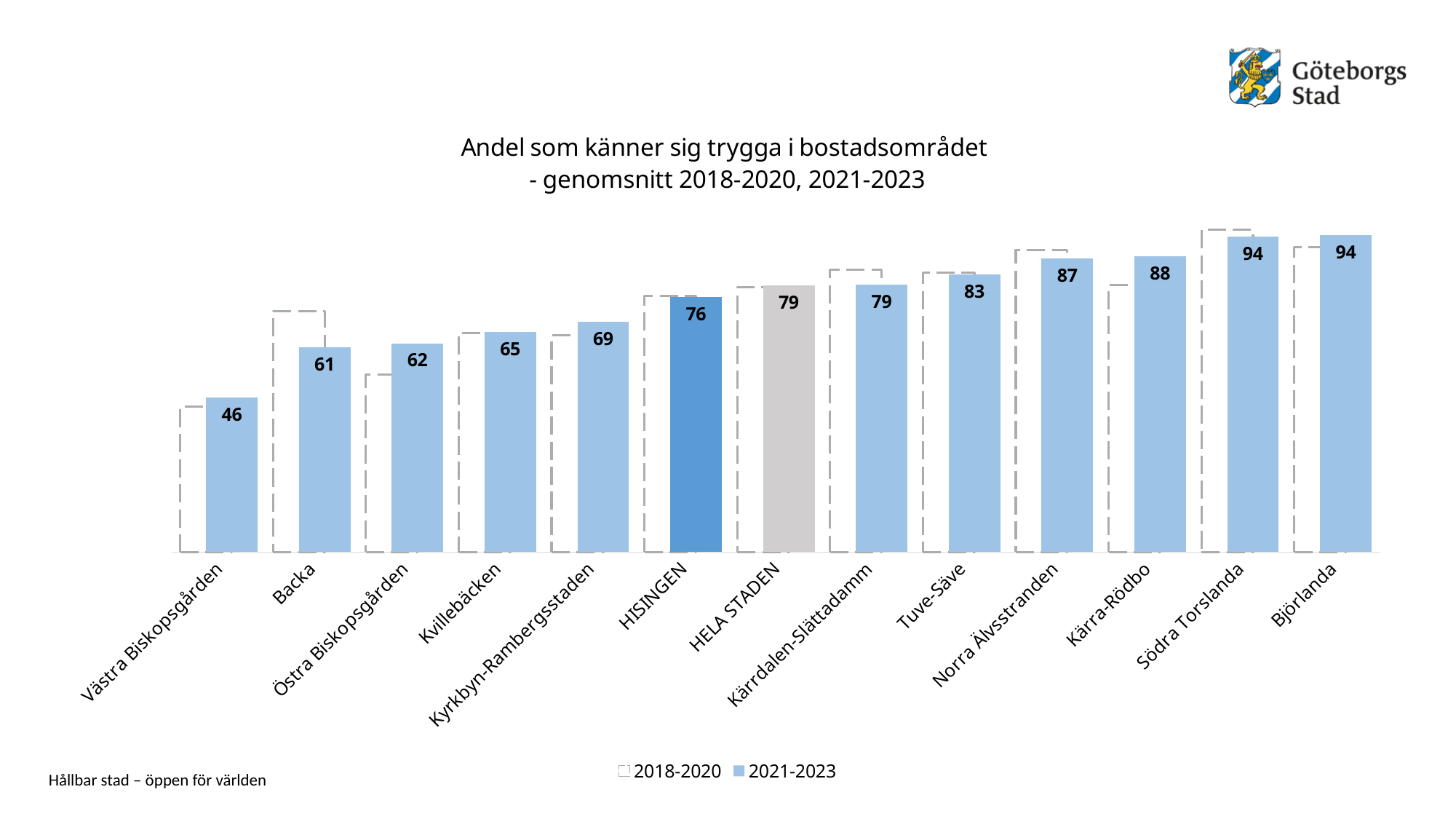
What kind of chart is shown on the slide? Bar chart What is the difference between the 2021-2023 values for Björlanda and Västra Biskopsgården? 48 What is the 2021-2023 value for HELA STADEN? 79 Which has the higher 2021-2023 value, Tuve-Säve or Kvillebäcken? Tuve-Säve What is the 2021-2023 value for Norra Älvstranden? 87 Do the 2021-2023 values generally rise or fall from left to right along the x axis? Rise How many series does the legend list? 2 What is the difference between the 2021-2023 values for Kärra-Rödbo and Backa? 27 How many categories are shown on the x axis? 13 What are the two entries in the chart legend? 2018-2020 and 2021-2023 What is the 2021-2023 value for Västra Biskopsgården? 46 Which area has the lowest 2021-2023 value? Västra Biskopsgården